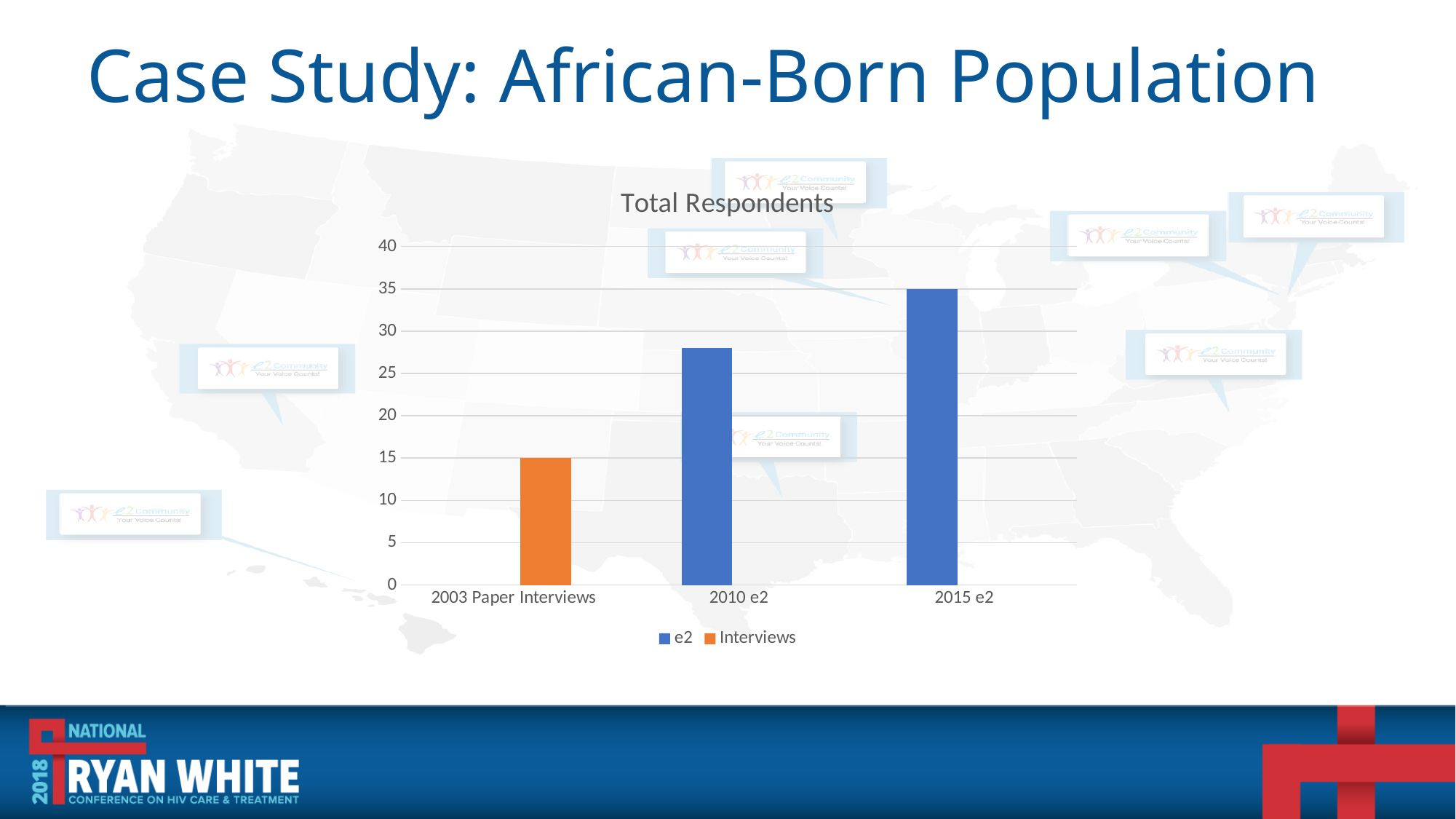
How many categories are shown on the x axis of the chart? 3 Do the values rise or fall from left to right along the x axis? rise Is the value for 2010 e2 greater or less than 25? greater What is the value for 2003 Paper Interviews? 15 Is the value for 2010 e2 greater or less than 30? less What is the difference between the values for 2015 e2 and 2003 Paper Interviews? 20 Which category has the lowest value? 2003 Paper Interviews What type of chart is shown on the slide? bar chart What is the value for 2015 e2? 35 Which category has the highest value? 2015 e2 How many series does the chart legend list? 2 What is the title of the chart? Total Respondents